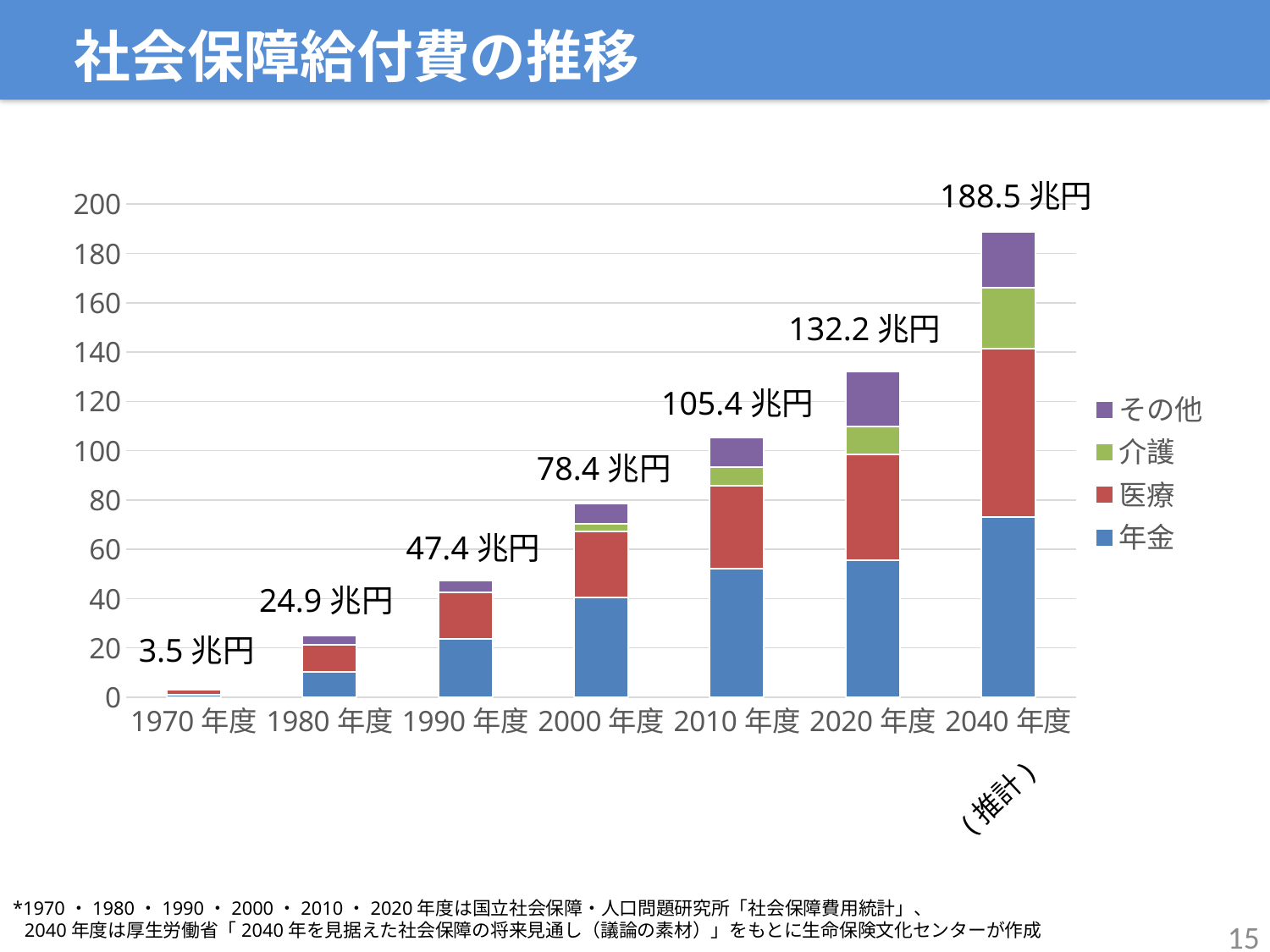
How many series does the legend list? 4 What is the difference between the total for 2010年度 and the total for 2000年度? 27.0 兆円 What is the total social security benefit expenditure shown for 2040年度? 188.5 兆円 What is the total value labeled for 2000年度? 78.4 兆円 Is the 年金 segment for 2040年度 greater or less than 60? greater What is the total value labeled for 1970年度? 3.5 兆円 Which is larger, the total for 1990年度 or the total for 1980年度? 1990 年度 Do the total values rise or fall from 1970年度 to 2040年度? rise Which fiscal year has the lowest total social security benefit expenditure? 1970 年度 How many fiscal years are shown on the x axis? 7 Which fiscal year has the highest total social security benefit expenditure? 2040 年度 What is the difference between the total for 2040年度 and the total for 2020年度? 56.3 兆円